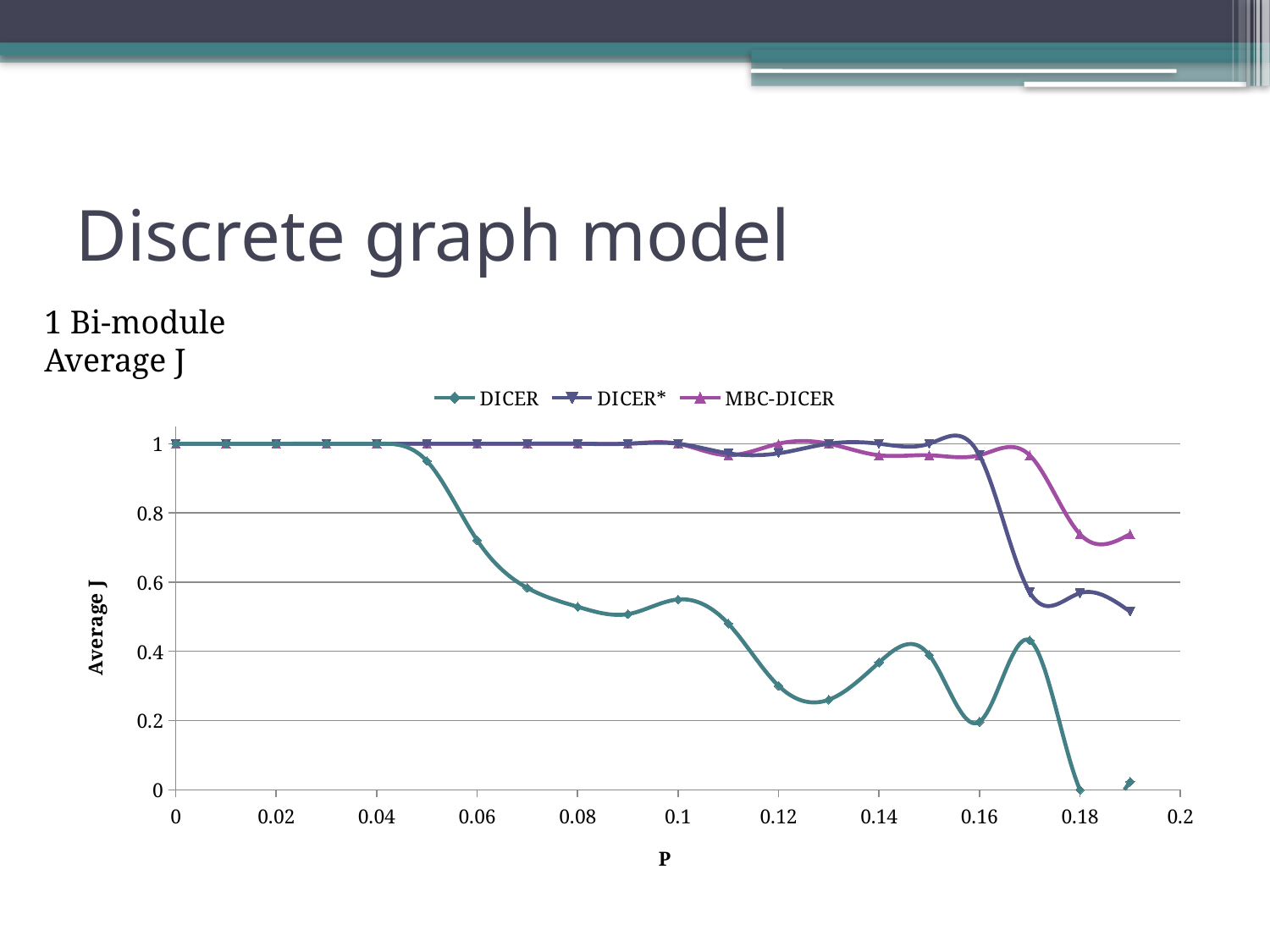
Is the value for MBC-DICER at P = 0.18 greater or less than 0.8? less Is the value for DICER* at P = 0.17 greater or less than 0.8? less Is the value for DICER at P = 0.06 greater or less than 0.6? greater At P = 0.19, which series has the higher value, MBC-DICER or DICER*? MBC-DICER How many series does the legend list? 3 At which value of P does the DICER series reach its lowest value? 0.18 What is the title of the vertical axis? Average J At P = 0.17, which series has the higher value, DICER or DICER*? DICER* What is the value of DICER at P = 0? 1 What kind of chart is shown on the slide? line chart What is the value of DICER at P = 0.18? 0